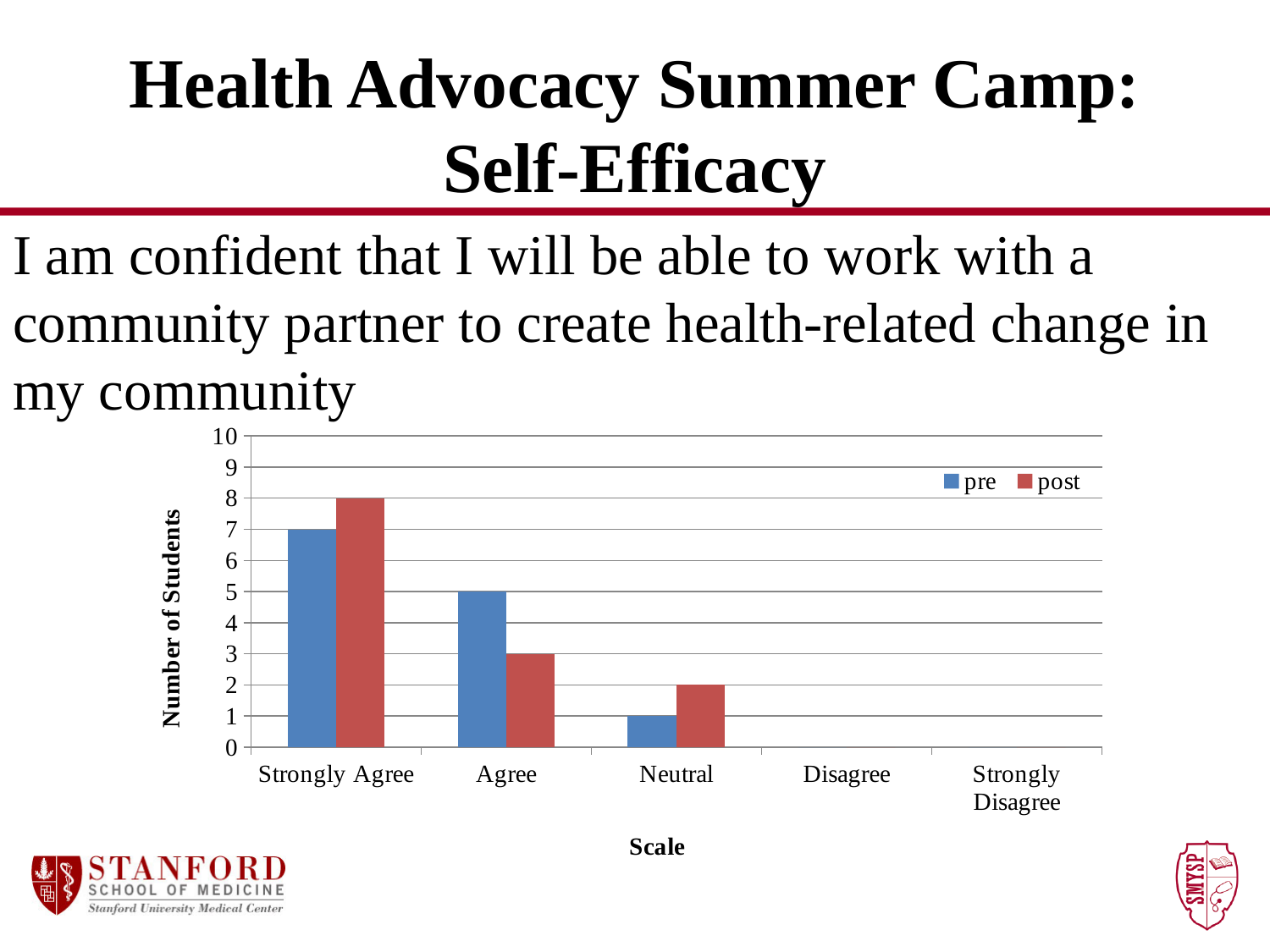
Which is larger for Neutral, the pre value or the post value? post What is the post value for Neutral? 2 Which category has the highest post value? Strongly Agree Is the pre value for Strongly Agree greater or less than 6? greater What is the post value for Strongly Agree? 8 What kind of chart is shown on the slide? bar chart What is the pre value for Agree? 5 What is the label of the y axis? Number of Students What is the pre value for Strongly Agree? 7 How many series does the legend list? 2 What is the difference between the pre and post values for Agree? 2 How many categories are shown on the x axis? 5